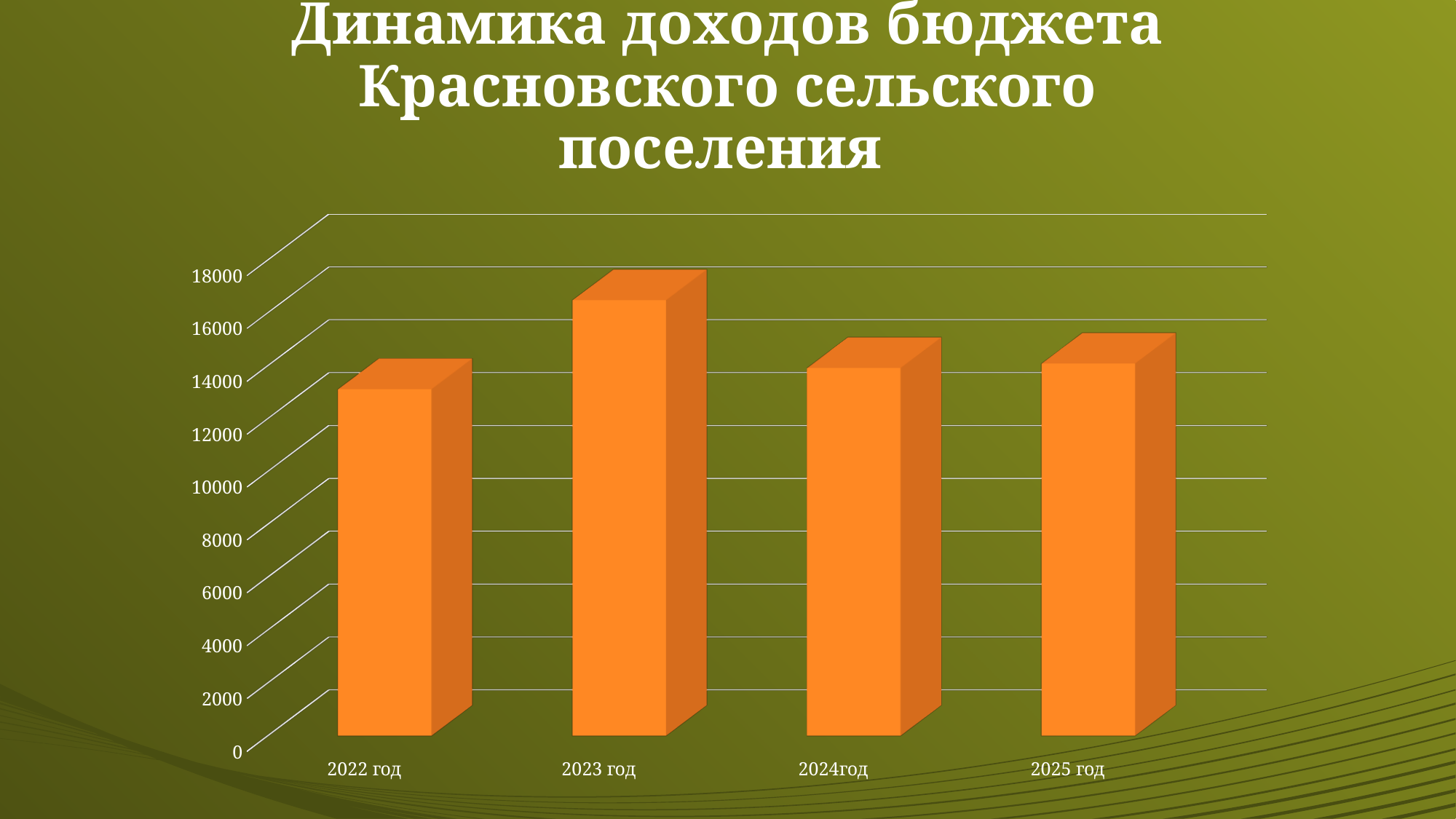
How many categories (years) are shown on the x axis of the chart? 4 Is the value for 2023 год greater or less than 16000? greater Is the value for 2025 год greater or less than 16000? less Which is larger, the value for 2023 год or the value for 2024год? 2023 год Which year has the highest budget income in the chart? 2023 год Is the value for 2023 год greater or less than 18000? less What kind of chart is shown on the slide? bar chart Which is larger, the value for 2022 год or the value for 2023 год? 2023 год Does the value rise or fall from 2022 год to 2023 год? rise Which year has the lowest budget income in the chart? 2022 год What is the title of the chart on the slide? Динамика доходов бюджета Красновского сельского поселения